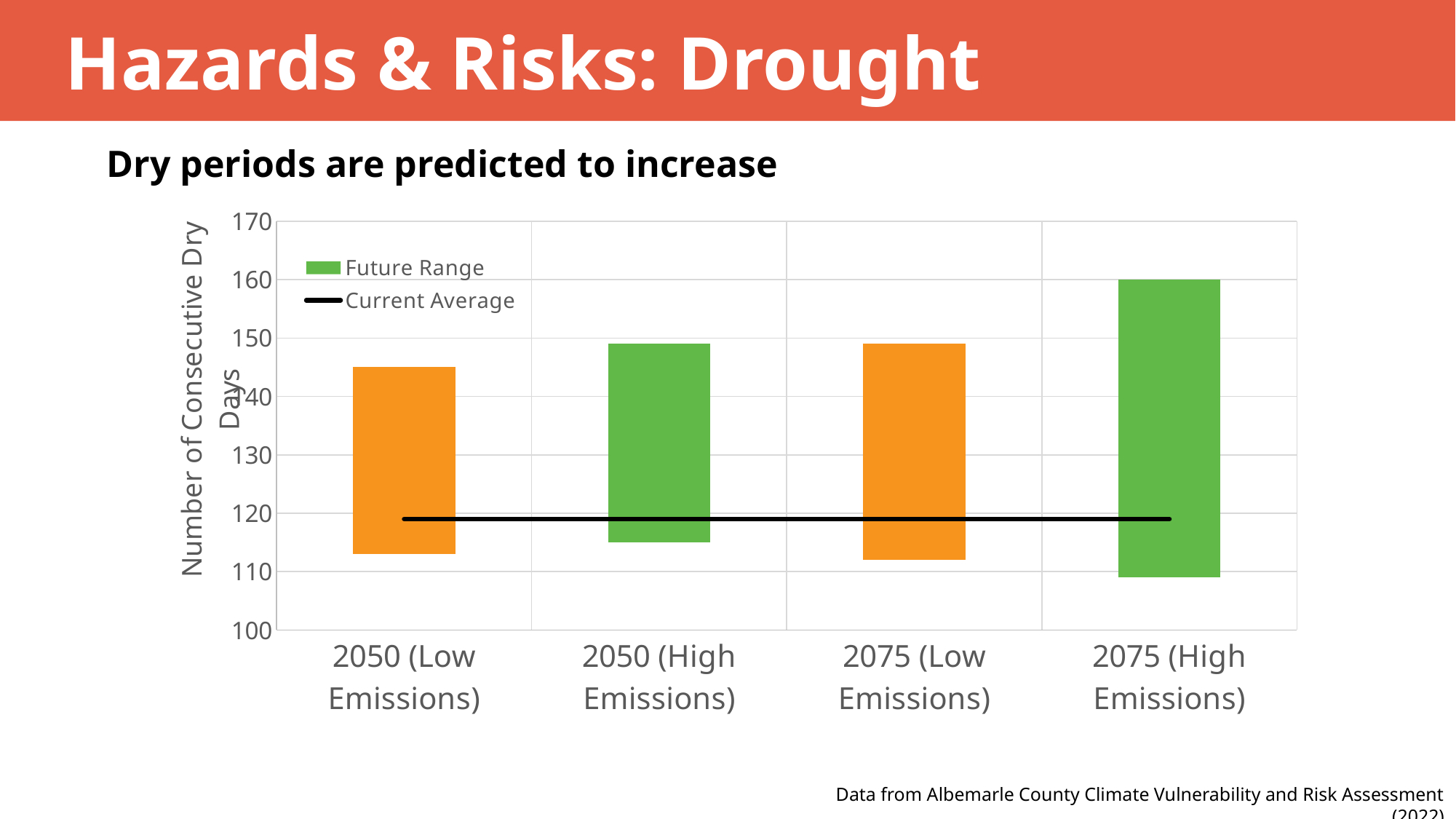
What does the black horizontal line represent according to the legend? Current Average Which scenario has the highest top of its future range? 2075 (High Emissions) Is the top of the future range for 2050 (Low Emissions) greater or less than 150 days? less What kind of chart is shown on the slide? combination bar and line chart Is the bottom of the future range for 2050 (High Emissions) greater or less than 120 days? less Is the top of the future range for 2075 (High Emissions) greater or less than 150 days? greater What is the label on the vertical axis? Number of Consecutive Dry Days How many entries does the legend list? 2 Which has a higher top of its future range, 2050 (Low Emissions) or 2075 (High Emissions)? 2075 (High Emissions) How many scenario categories are shown on the x axis? 4